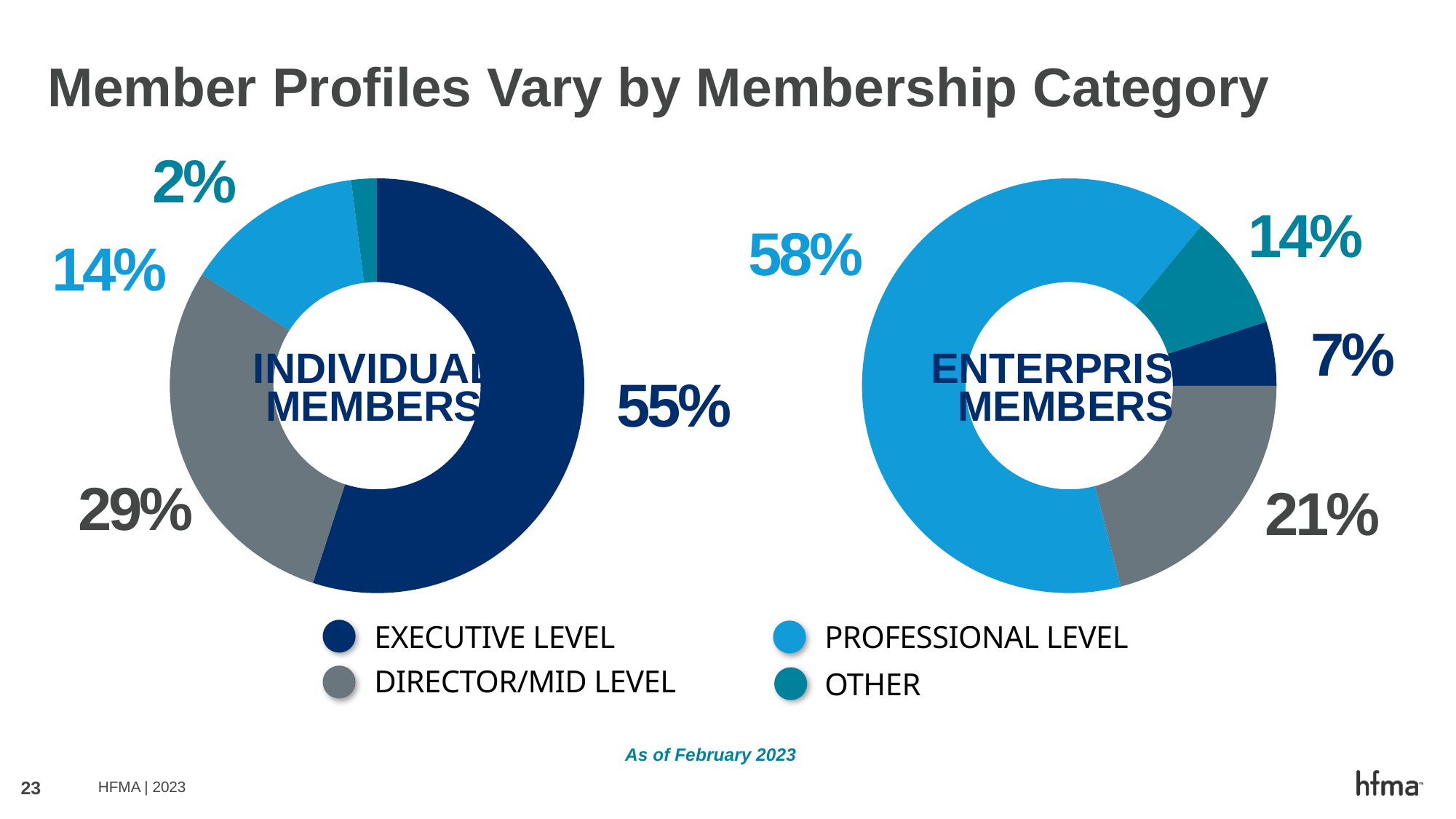
In the Enterprise Members chart, what share of members are Executive Level? 7% In the Individual Members chart, which category has the largest share? Executive Level What is the difference between the Executive Level share in the Individual Members chart and the Executive Level share in the Enterprise Members chart? 48 percentage points In the Individual Members chart, what share of members are Director/Mid Level? 29% In the Enterprise Members chart, which category has the smallest share? Executive Level What kind of chart is used for the Individual Members data? Pie (doughnut) chart In the Individual Members chart, which category has the smallest share? Other In the Enterprise Members chart, what share of members are Professional Level? 58% Which is larger: the Director/Mid Level share in the Individual Members chart or in the Enterprise Members chart? Individual Members In the Individual Members chart, what share of members are Executive Level? 55% How many categories does the legend list? 4 In the Enterprise Members chart, what share of members are Other? 14%